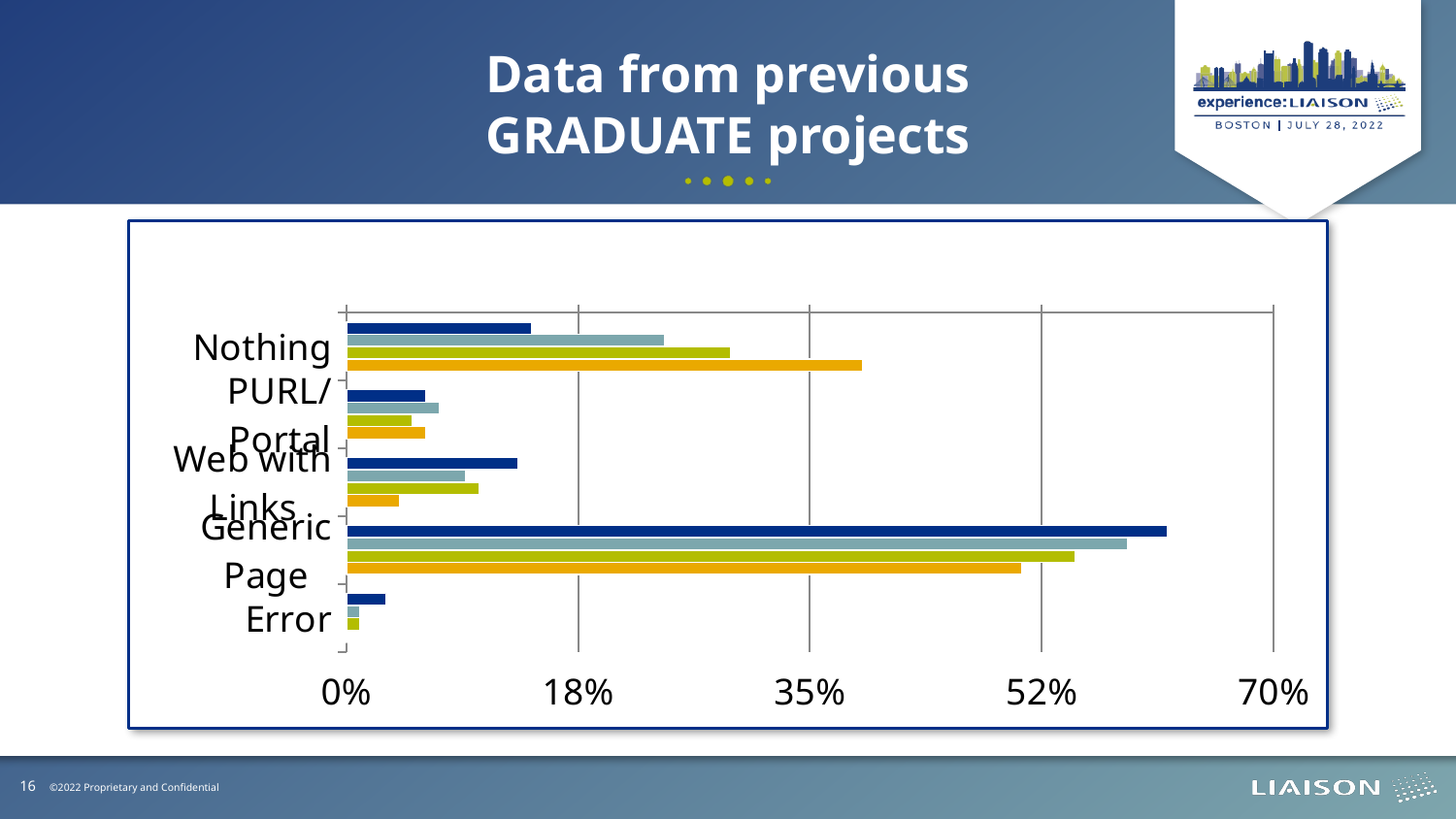
Is the value of the dark blue bar for Web with Links greater or less than 18%? less Which category has the shortest bars in the chart? Error What is the highest value shown on the horizontal axis of the chart? 70% Is the value of the orange bar for Nothing greater or less than 35%? greater Which category has the longest bars in the chart? Generic Page Is the value of the dark blue bar for Error greater or less than 18%? less What kind of chart is shown on the slide? bar chart How many categories are shown on the vertical axis of the chart? 5 Which category has a larger dark blue bar, Nothing or Error? Nothing Which category has a larger orange bar, Generic Page or Web with Links? Generic Page